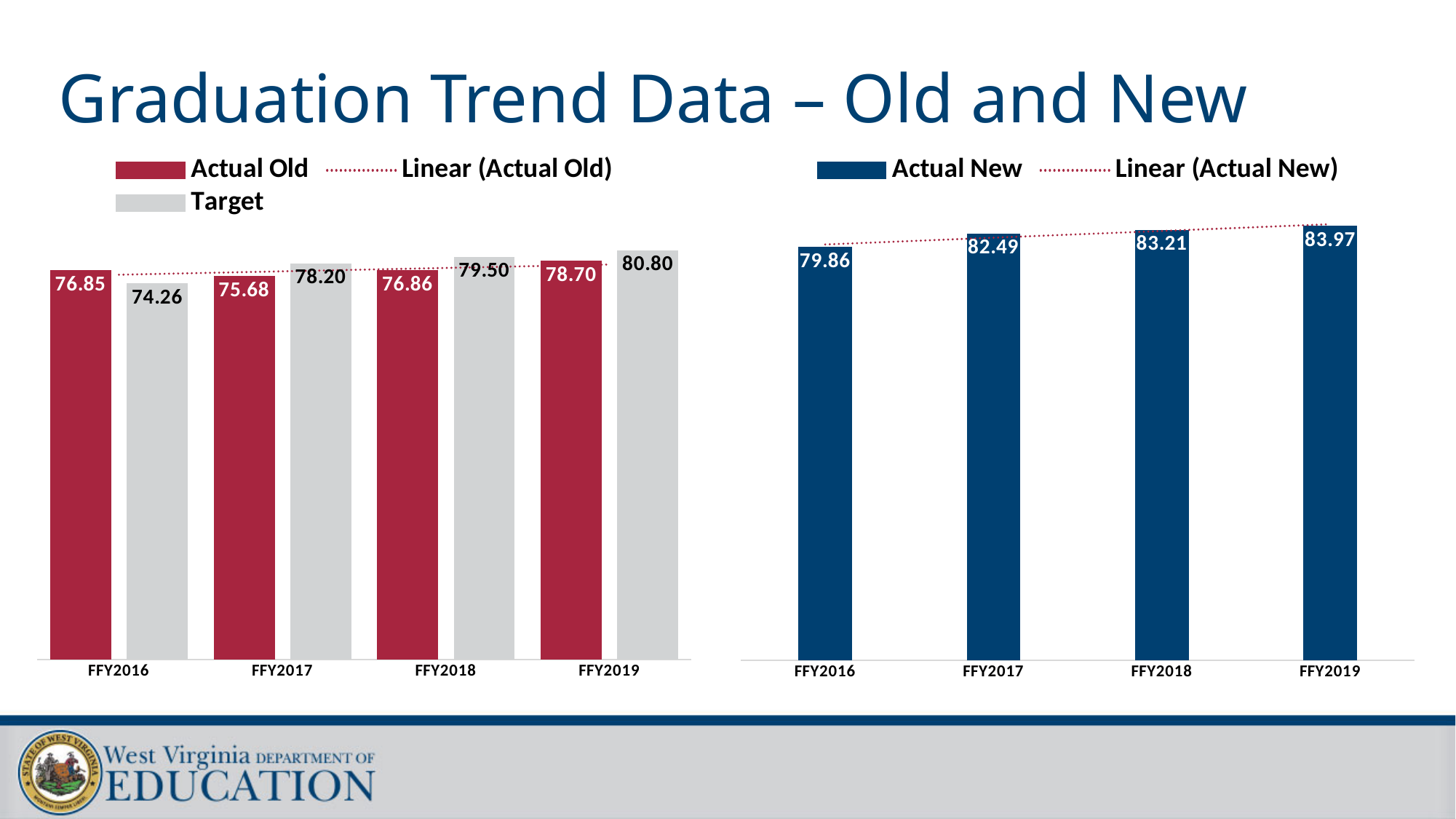
In the left chart, what is the Actual Old value for FFY2017? 75.68 In the left chart, which is larger for FFY2016, Actual Old or Target? Actual Old In the right chart, which year has the highest Actual New value? FFY2019 In the left chart, which year has the lowest Actual Old value? FFY2017 In the right chart, do the Actual New values rise or fall from FFY2016 to FFY2019? rise What kind of chart is the right chart? bar chart In the left chart, how many entries does the legend list? 3 In the right chart, what is the difference between the Actual New values for FFY2019 and FFY2016? 4.11 In the left chart, what is the Target value for FFY2019? 80.80 In the right chart, how many years are shown on the x axis? 4 In the right chart, what is the Actual New value for FFY2018? 83.21 In the left chart, what is the difference between the Target and Actual Old values for FFY2019? 2.10